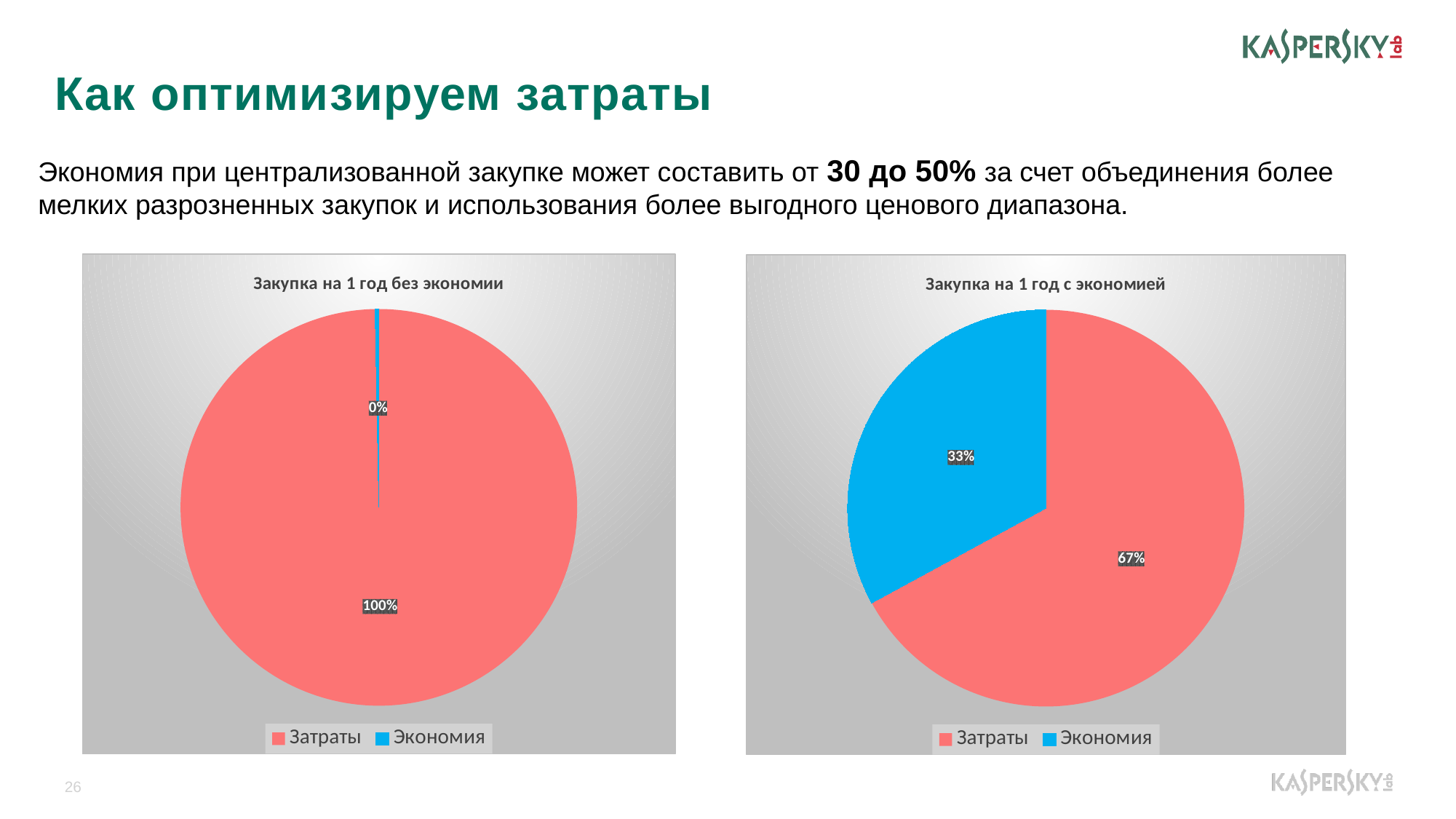
What is the title of the chart on the right of the slide? Закупка на 1 год с экономией In the chart titled "Закупка на 1 год с экономией", which slice is the largest? Затраты In the chart titled "Закупка на 1 год с экономией", what is the difference between the Затраты and Экономия shares? 34% In the chart titled "Закупка на 1 год с экономией", which is larger, Затраты or Экономия? Затраты In the chart titled "Закупка на 1 год с экономией", what share does Затраты have? 67% What kind of chart is the chart on the left of the slide? Pie chart In the chart titled "Закупка на 1 год без экономии", what share does Затраты have? 100% In the chart titled "Закупка на 1 год без экономии", what share does Экономия have? 0% In the chart titled "Закупка на 1 год с экономией", which slice is the smallest? Экономия How many series does the legend of the chart titled "Закупка на 1 год с экономией" list? 2 In the chart titled "Закупка на 1 год без экономии", what colour is the Экономия slice? Blue